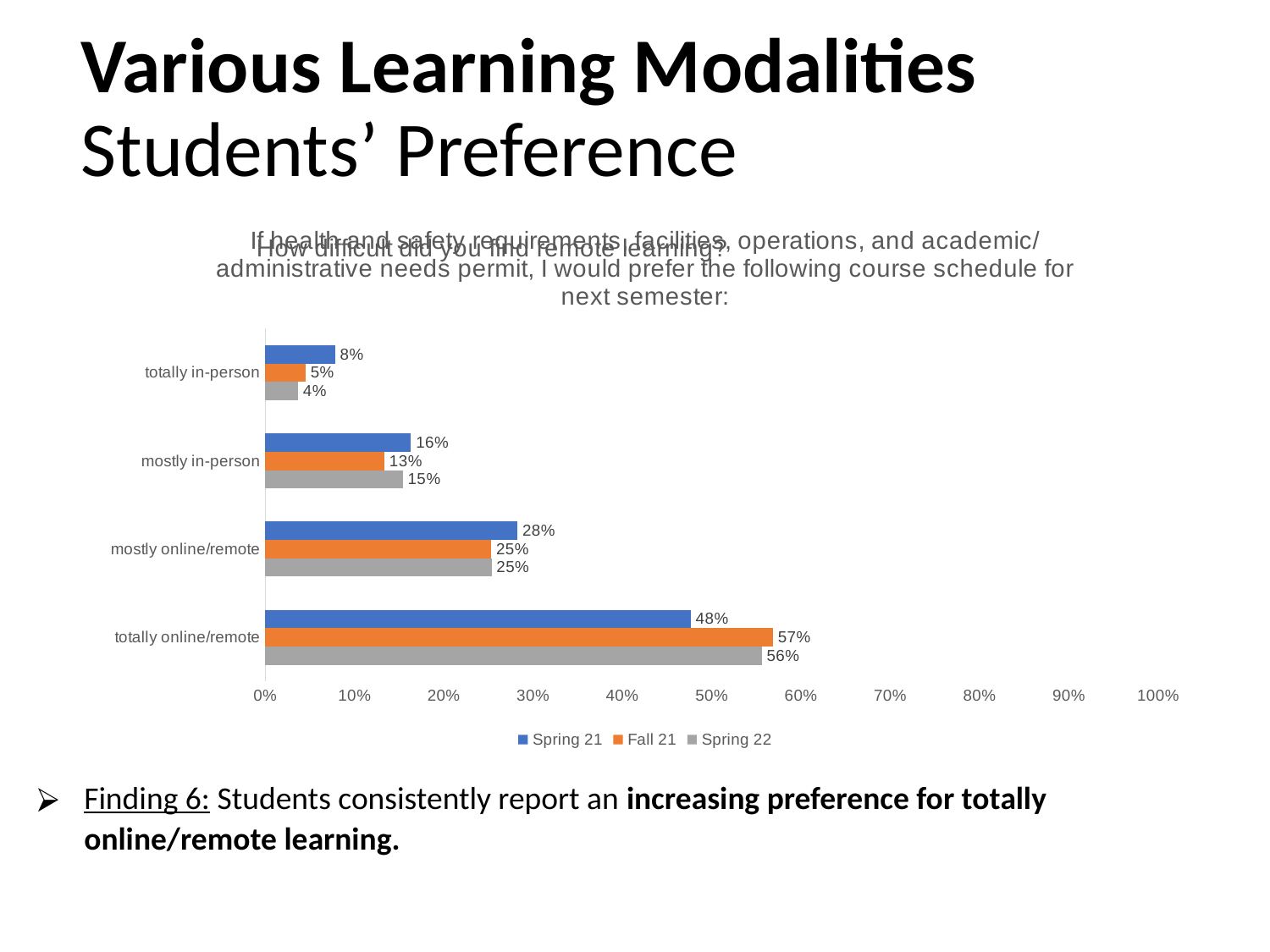
What is the Fall 21 value for totally in-person? 5% What is the Spring 21 value for totally online/remote? 48% Which is larger for mostly in-person: the Spring 21 value or the Fall 21 value? Spring 21 Which category has the lowest Fall 21 value? totally in-person What is the Fall 21 value for totally online/remote? 57% How many categories are shown on the chart? 4 How many series does the legend list? 3 What is the Spring 22 value for mostly in-person? 15% Which category has the highest Spring 22 value? totally online/remote What kind of chart is shown on the slide? bar chart Is the Spring 22 value for totally online/remote greater or less than 50%? greater What is the difference between the Fall 21 and Spring 21 values for totally online/remote? 9%